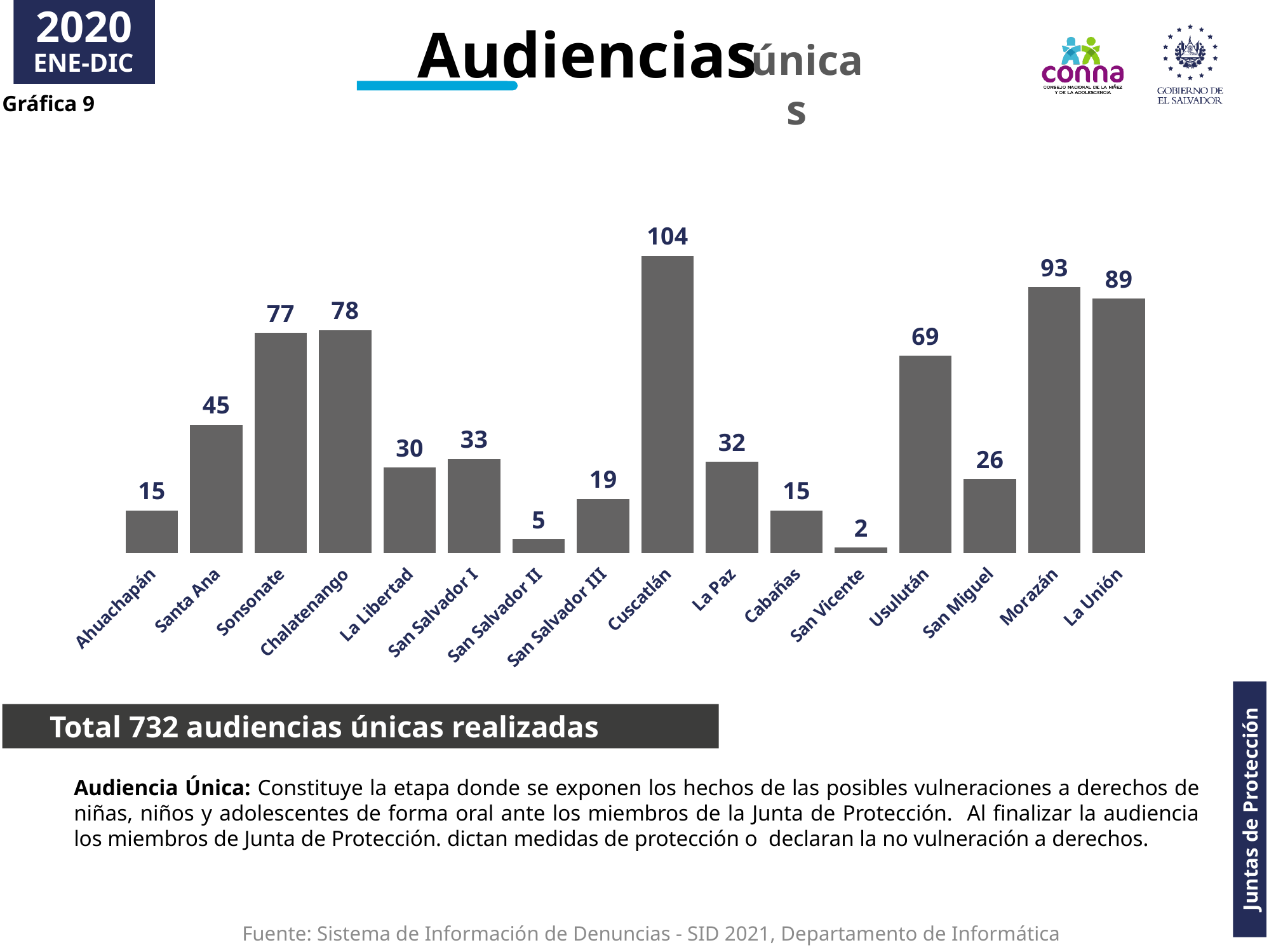
What is the value for Cuscatlán? 104 Which is larger, the value for La Libertad or the value for San Salvador I? San Salvador I What is the difference between the values for Morazán and La Unión? 4 What kind of chart is shown on the slide? Bar chart What is the value for San Salvador III? 19 How many categories are shown on the x axis? 16 Which category has the highest value? Cuscatlán What total is stated in the banner below the chart? 732 Which category has the lowest value? San Vicente What is the difference between the values for Sonsonate and Santa Ana? 32 What is the value for San Salvador II? 5 What is the value for Usulután? 69